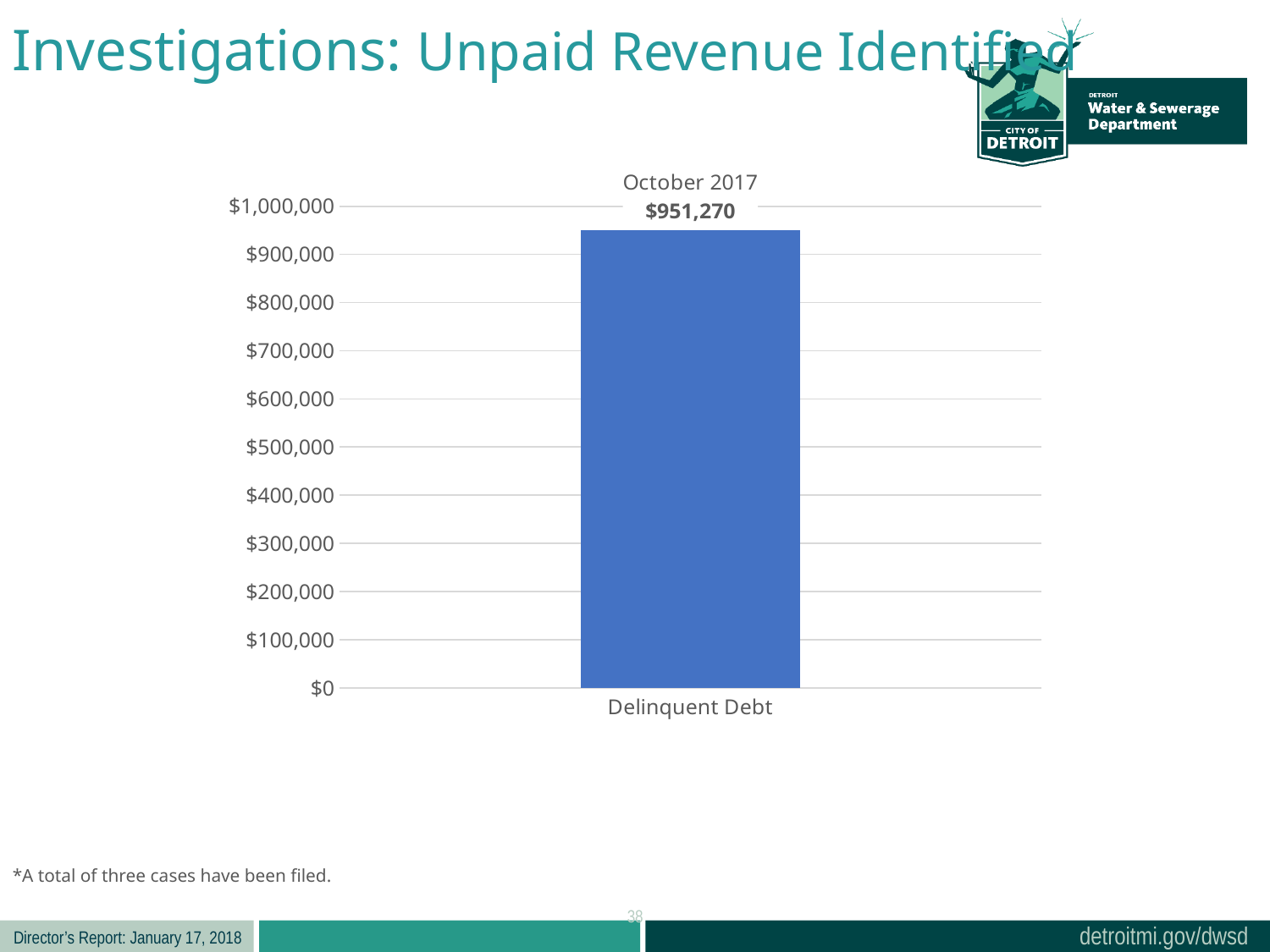
What is the title of the chart? October 2017 How many categories are plotted on the x axis of the chart? 1 What is the highest value shown on the y axis? $1,000,000 What is the value of the Delinquent Debt bar? $951,270 What kind of chart is shown on the slide? bar chart Is the value for Delinquent Debt greater or less than $1,000,000? less Is the value for Delinquent Debt greater or less than $900,000? greater What is the label of the category on the x axis? Delinquent Debt